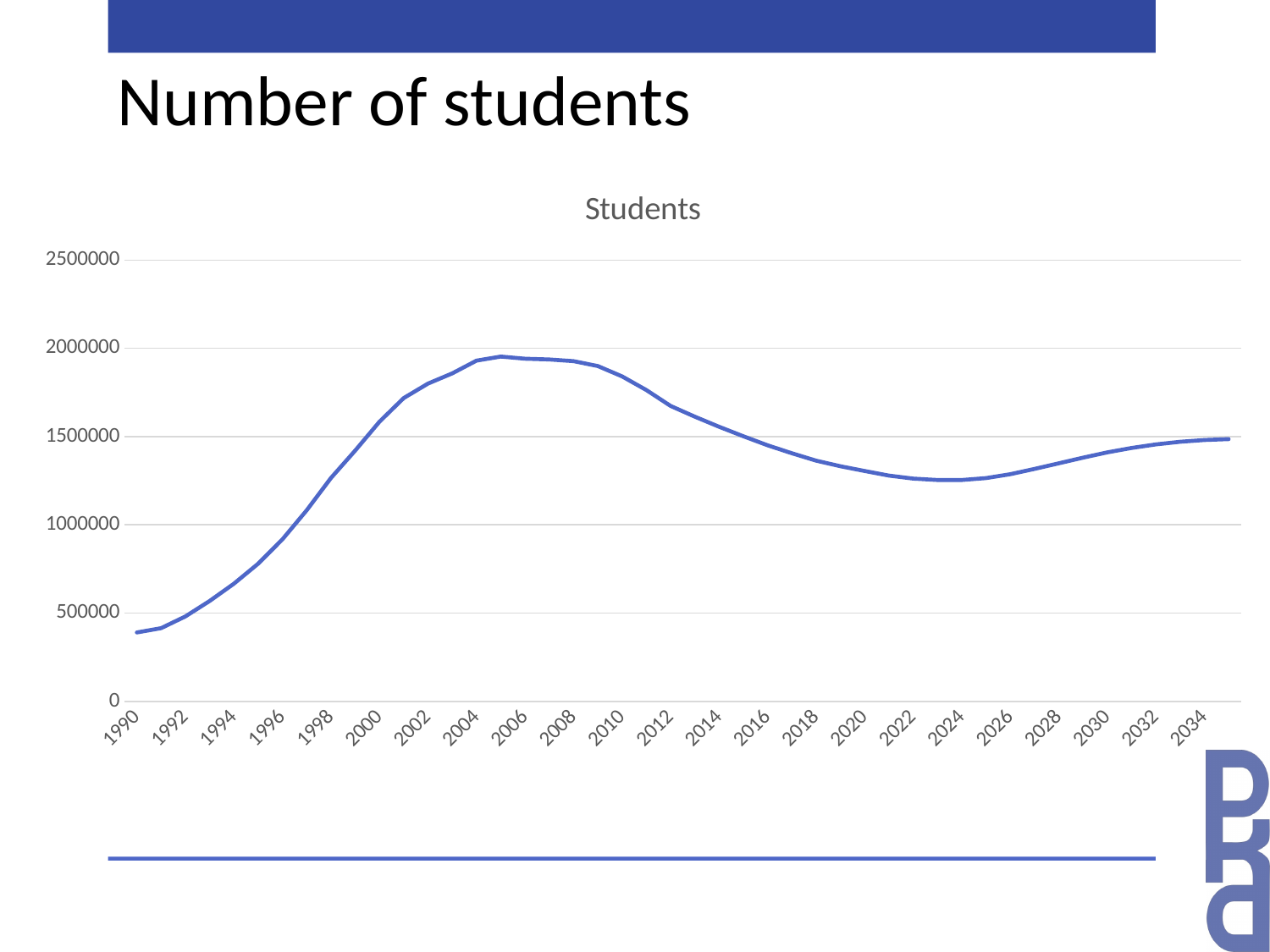
Does the line reach its highest value before or after 2010? before What is the title of the chart? Students Which year has the lowest number of students on the chart? 1990 Is the value for 2006 greater or less than 1500000? greater Is the value for 2024 greater or less than 1500000? less Is the value for 2018 greater or less than 1500000? less What kind of chart is shown on the slide? line chart Do the values rise or fall between 2006 and 2024? fall Which is larger, the value for 2006 or the value for 2024? 2006